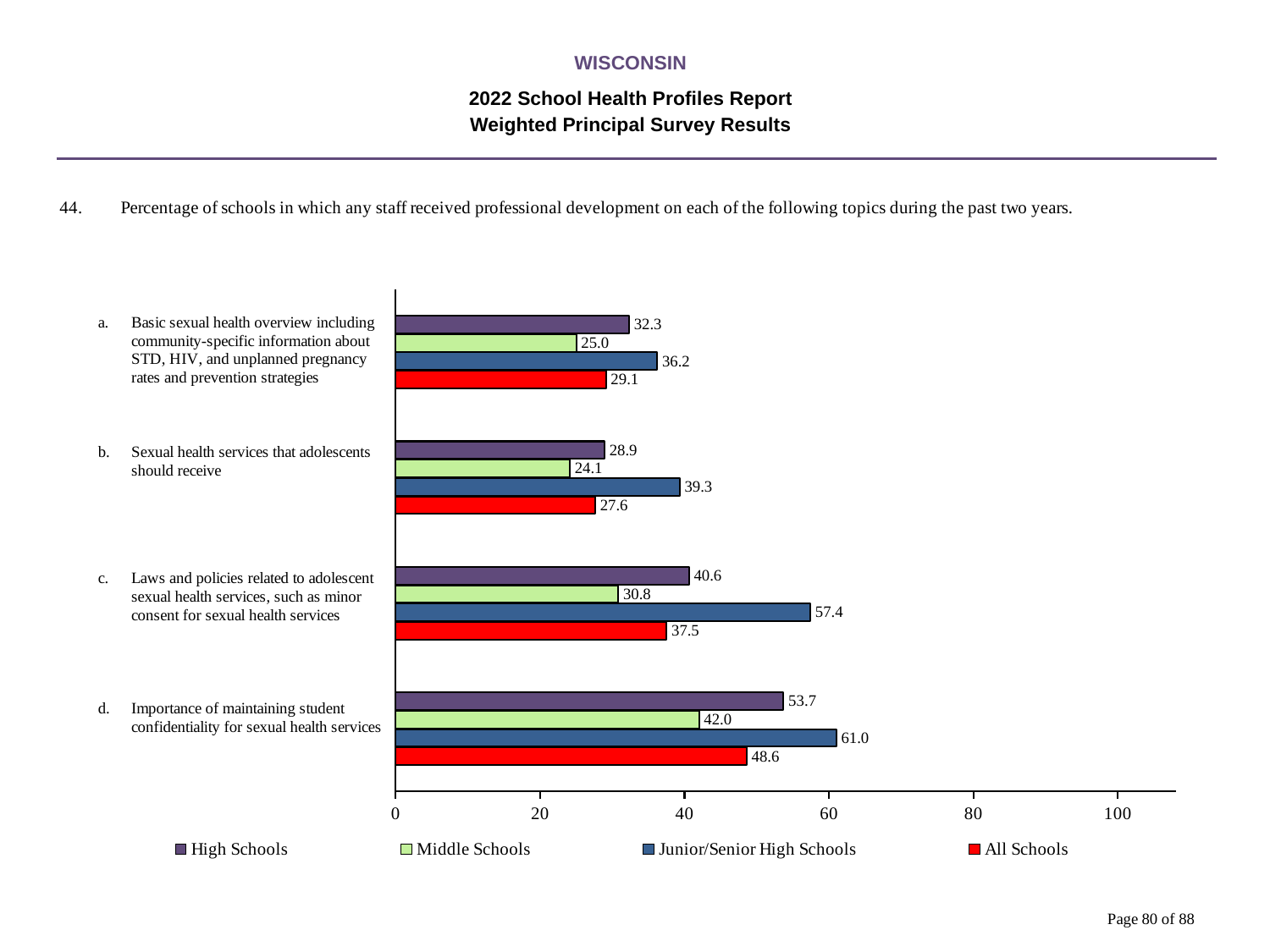
What is the value for All Schools for topic c, laws and policies related to adolescent sexual health services? 37.5 What is the difference between the Junior/Senior High Schools value and the Middle Schools value for topic c? 26.6 Is the value for Junior/Senior High Schools for topic d greater or less than 60? greater What kind of chart is shown on the slide? Bar chart Which topic has the highest value for High Schools? d. Importance of maintaining student confidentiality for sexual health services Which topic has the lowest value for Middle Schools? b. Sexual health services that adolescents should receive How many topics (categories) are shown in the chart? 4 Which colour represents All Schools in the legend? Red For topic b, which is larger: the High Schools value or the All Schools value? High Schools How many series does the legend list? 4 What is the value for Junior/Senior High Schools for topic d, importance of maintaining student confidentiality for sexual health services? 61.0 What is the value for Middle Schools for topic a, basic sexual health overview? 25.0